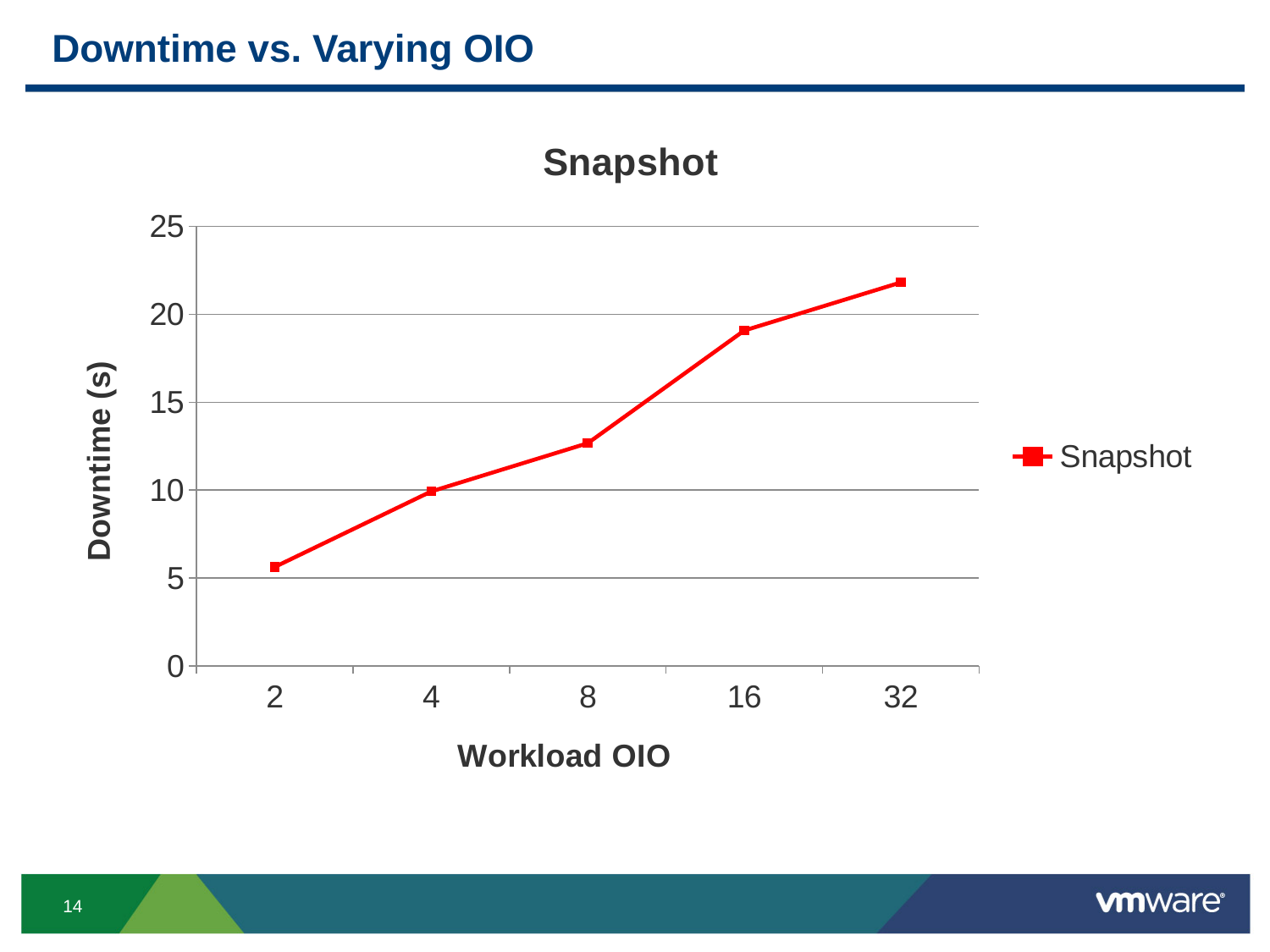
At which Workload OIO is the downtime highest? 32 Is the downtime for Workload OIO 16 greater or less than 20? less Is the downtime for Workload OIO 8 greater or less than 10? greater Which has the larger downtime, Workload OIO 8 or Workload OIO 16? 16 What kind of chart is shown on the slide? line chart How many Workload OIO values are plotted on the x axis? 5 Does the downtime rise or fall as Workload OIO increases along the x axis? rise Is the downtime for Workload OIO 32 greater or less than 20? greater At which Workload OIO is the downtime lowest? 2 What is the label of the y axis? Downtime (s) How many series does the legend list? 1